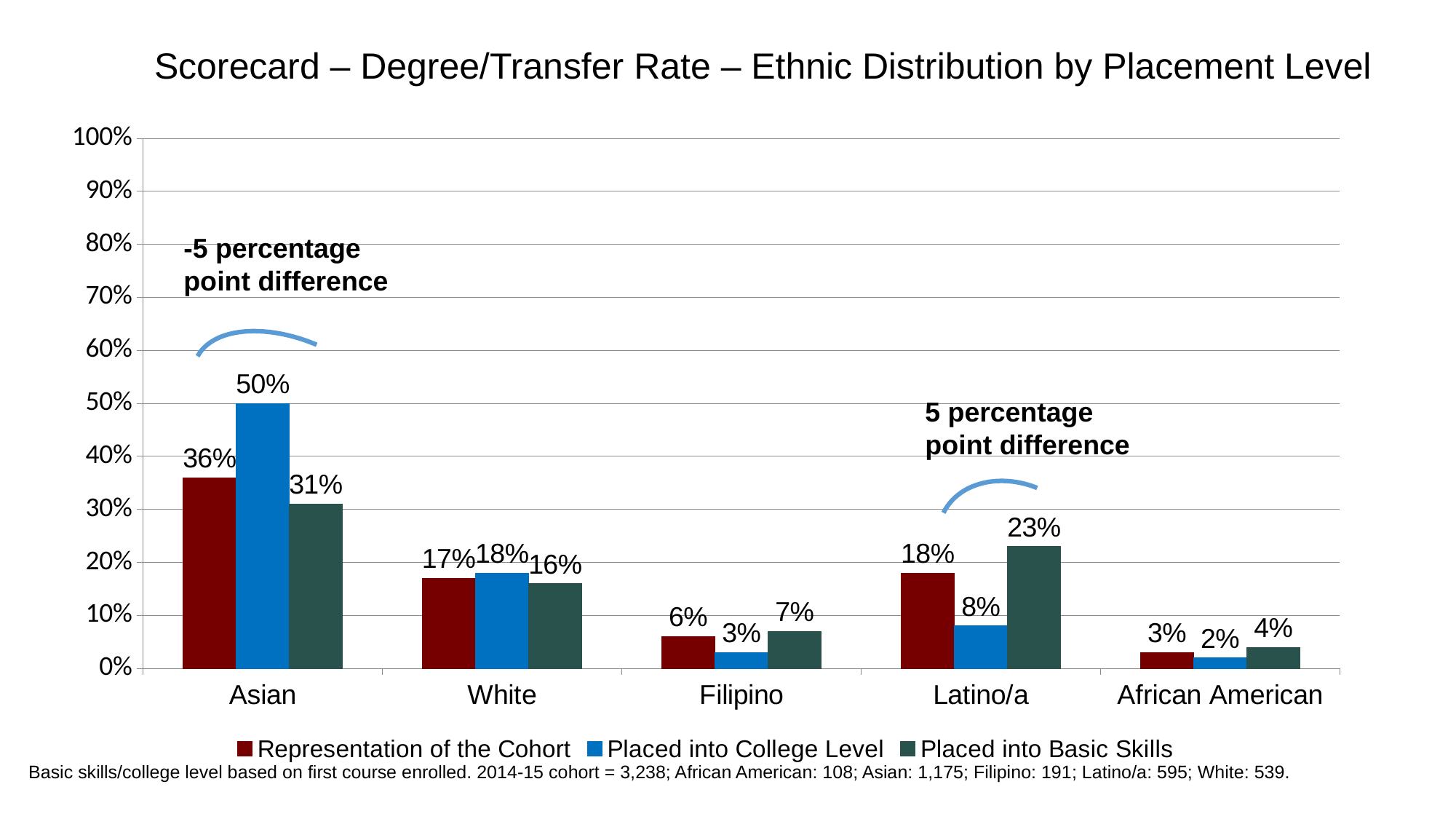
What is the difference between the Placed into Basic Skills and Representation of the Cohort values for Latino/a? 5% Which category has the lowest Representation of the Cohort value? African American What is the title of the chart? Scorecard – Degree/Transfer Rate – Ethnic Distribution by Placement Level What is the value for Asian in the Placed into College Level series? 50% What is the difference between the Placed into College Level and Representation of the Cohort values for Asian? 14% What is the value for Latino/a in the Placed into Basic Skills series? 23% Which category has the highest Placed into College Level value? Asian What is the Representation of the Cohort value for Filipino? 6% What kind of chart is shown on the slide? Bar chart How many ethnic categories are shown on the x axis? 5 How many series does the legend list? 3 Which is larger for Latino/a: Placed into College Level or Placed into Basic Skills? Placed into Basic Skills